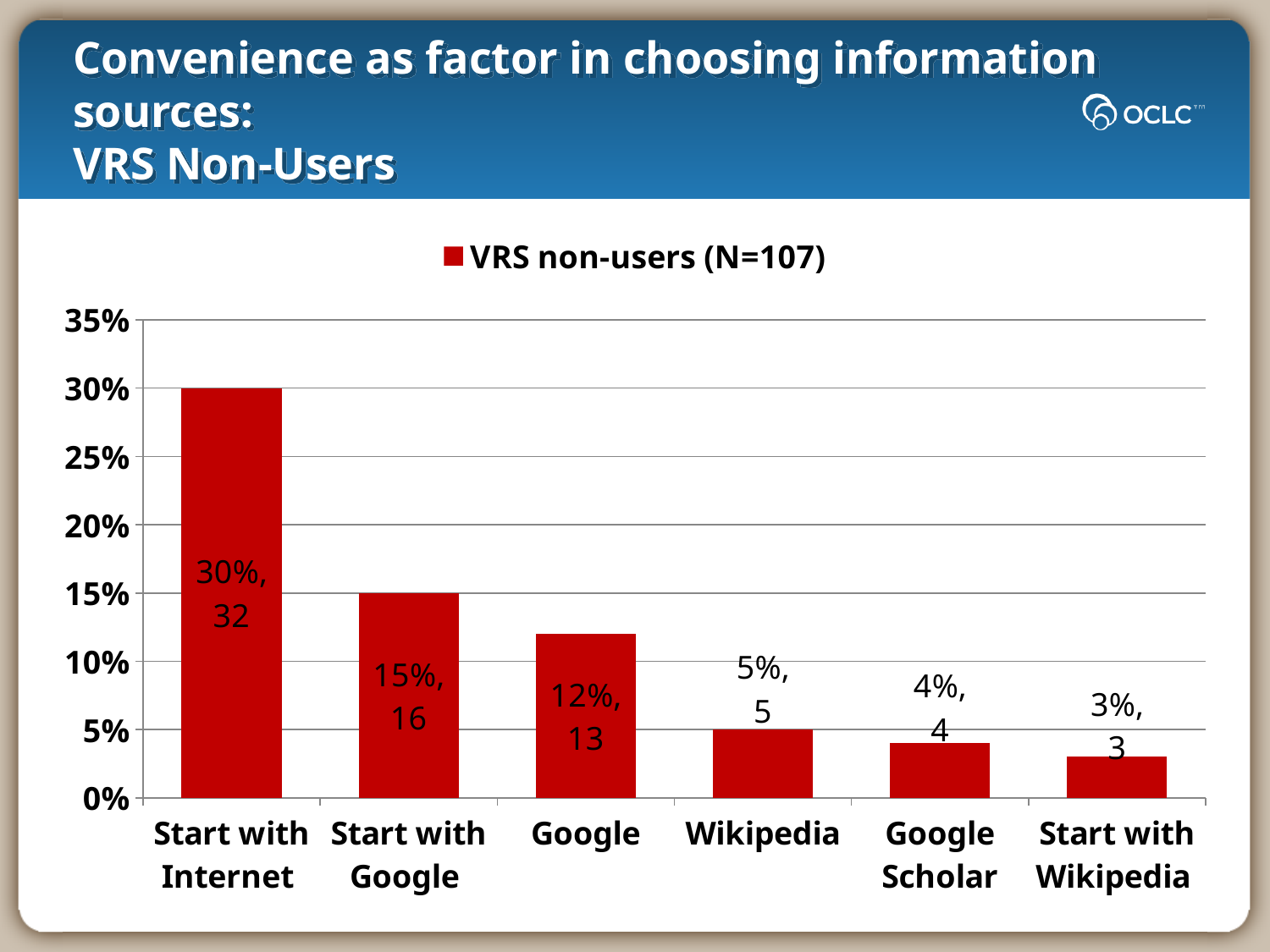
Which category has the lowest value? Start with Wikipedia How many respondents does the data label give for Google? 13 Which is larger, the value for Wikipedia or the value for Google Scholar? Wikipedia What percentage is shown for Google Scholar? 4% What percentage is shown for Start with Internet? 30% What is the legend entry for the series? VRS non-users (N=107) How many categories are shown on the x axis? 6 What kind of chart is shown? bar chart What is the difference in percentage points between Start with Internet and Start with Google? 15% Which category has the highest value? Start with Internet Is the value for Start with Google greater or less than 10%? greater How many series does the legend list? 1